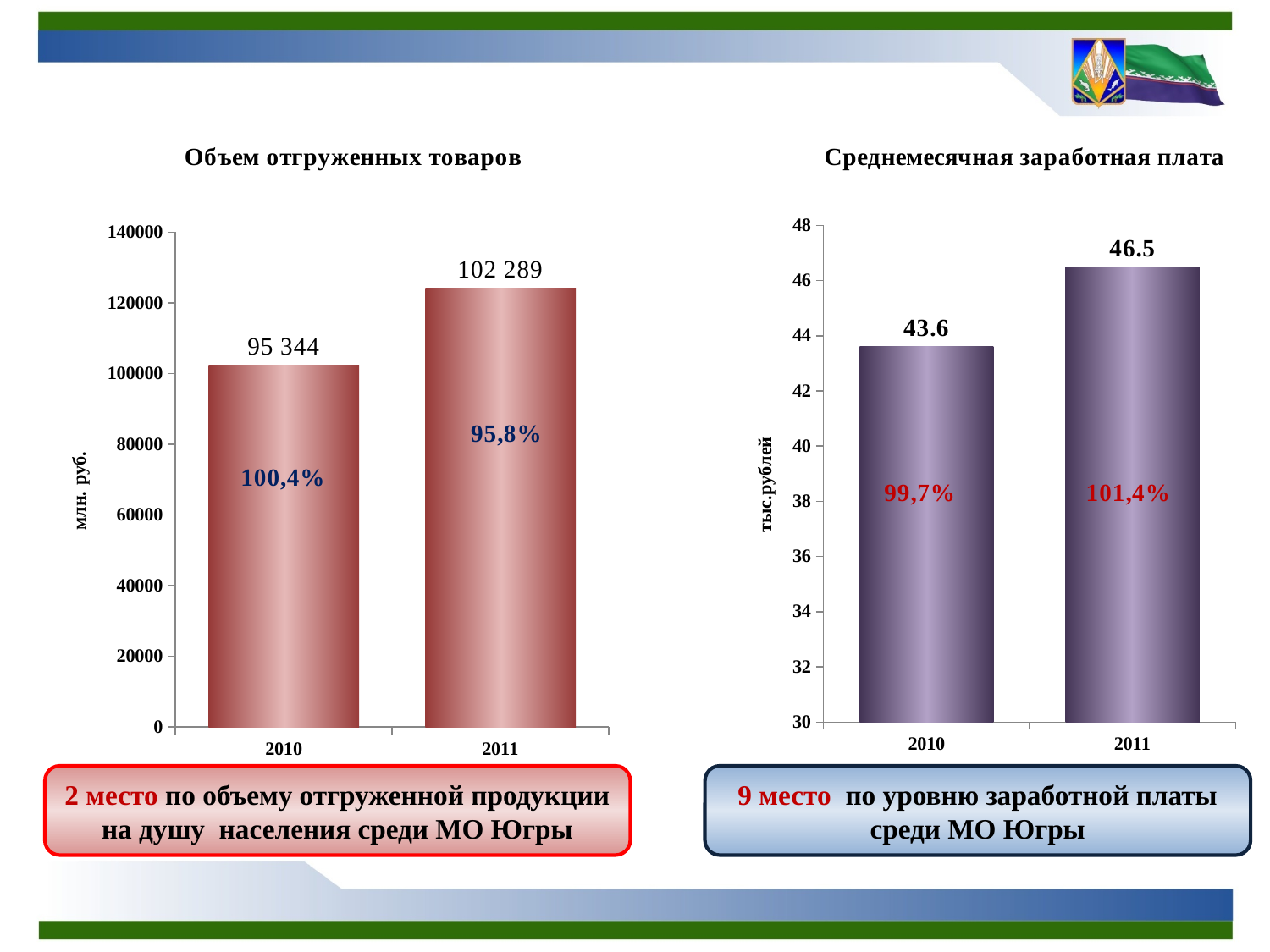
In the chart titled "Объем отгруженных товаров", what is the value for 2011? 102 289 In the chart titled "Среднемесячная заработная плата", how many bars are plotted? 2 In the chart titled "Объем отгруженных товаров", what percentage is printed inside the 2011 bar? 95,8% In the chart titled "Объем отгруженных товаров", what is the value for 2010? 95 344 In the chart titled "Объем отгруженных товаров", what is the difference between the 2011 and 2010 values? 6 945 What kind of chart is the chart titled "Среднемесячная заработная плата"? bar chart In the chart titled "Среднемесячная заработная плата", what is the difference between the 2011 and 2010 values? 2.9 In the chart titled "Среднемесячная заработная плата", what is the value for 2010? 43.6 In the chart titled "Объем отгруженных товаров", which year has the higher value? 2011 In the chart titled "Среднемесячная заработная плата", is the value for 2010 greater or less than 42? greater In the chart titled "Среднемесячная заработная плата", which year has the lower value? 2010 In the chart titled "Среднемесячная заработная плата", what is the value for 2011? 46.5